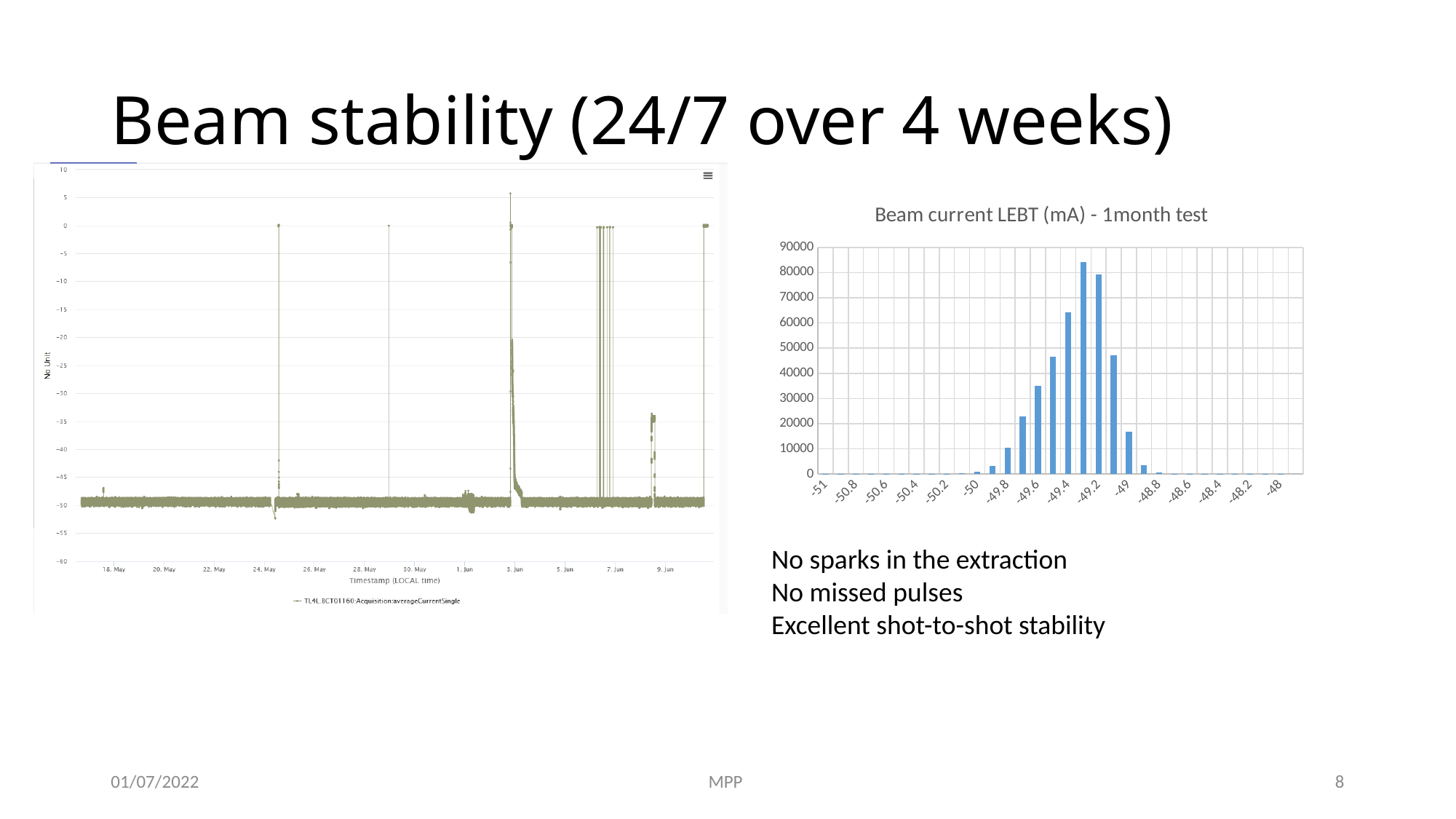
What is the title of the bar chart on the right of the slide? Beam current LEBT (mA) - 1month test What kind of chart is the chart on the left of the slide? line chart In the bar chart on the right, is the value of the bar at -49.6 greater or less than 30000? greater In the chart on the left, what is the label of the horizontal axis? Timestamp (LOCAL time) In the bar chart on the right, is the value of the bar at -49.4 greater or less than 60000? greater In the bar chart on the right, which bar is taller, the one at -49.6 or the one at -49? -49.6 In the bar chart on the right, is the value of the tallest bar greater or less than 80000? greater What kind of chart is the chart on the right of the slide? bar chart In the bar chart on the right, what is the highest value shown on the vertical axis? 90000